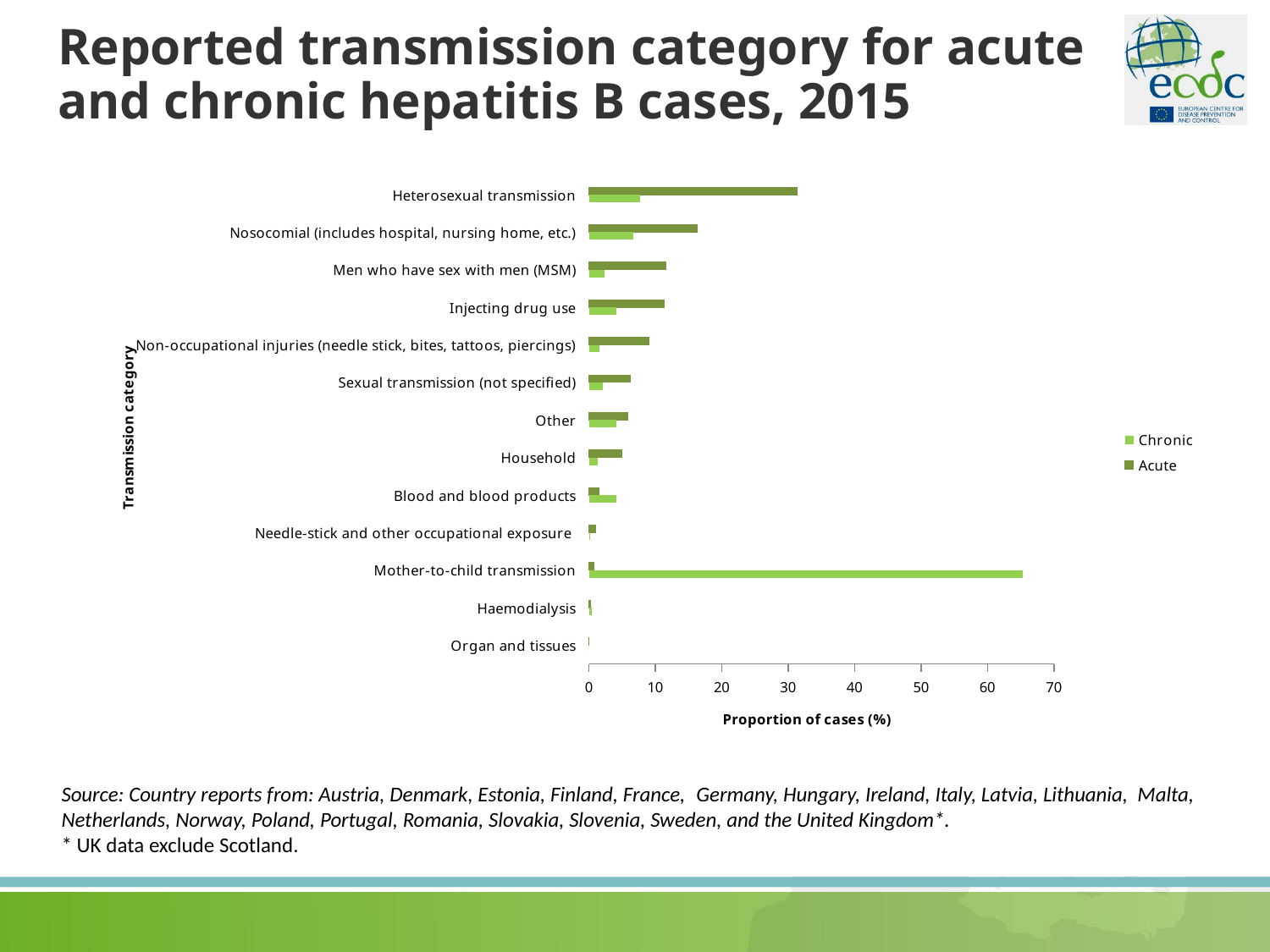
Is the Chronic value for Mother-to-child transmission greater or less than 60? greater What kind of chart is shown on the slide? Bar chart Which transmission category has the highest Chronic value? Mother-to-child transmission Which transmission category has the highest Acute value? Heterosexual transmission Is the Acute value for Nosocomial (includes hospital, nursing home, etc.) greater or less than 10? greater How many transmission categories are shown on the y axis? 13 For Mother-to-child transmission, which series has the larger value, Chronic or Acute? Chronic What is the label of the x axis? Proportion of cases (%) How many series does the legend list? 2 Is the Acute value for Heterosexual transmission greater or less than 20? greater For Heterosexual transmission, which series has the larger value, Chronic or Acute? Acute